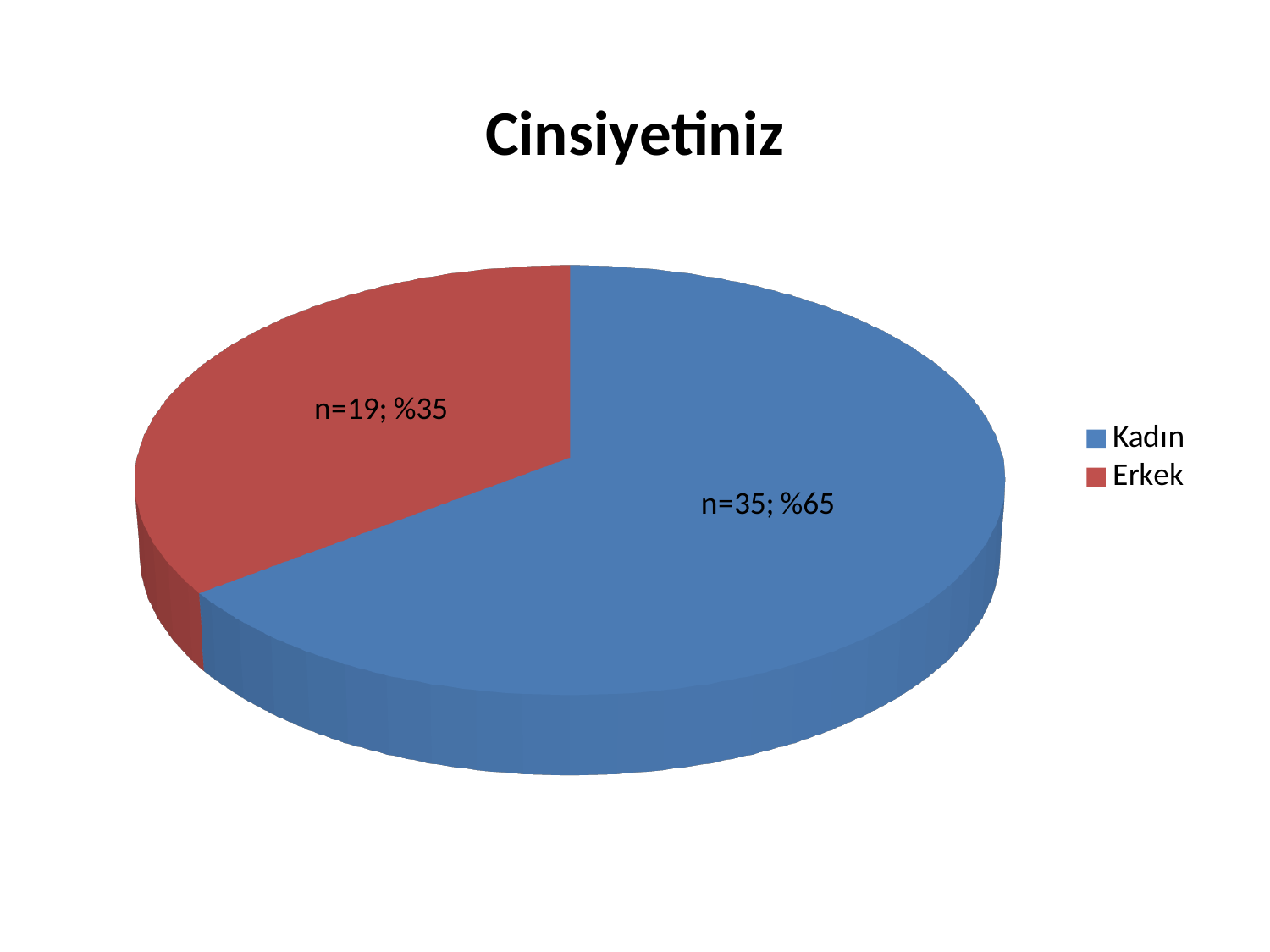
What is the count (n) for Kadın? n=35 What share of the pie does Kadın represent? %65 What is the title of the chart? Cinsiyetiniz What is the count (n) for Erkek? n=19 How many slices does the pie chart have? 2 Which colour represents Erkek in the chart? red What share of the pie does Erkek represent? %35 What kind of chart is shown on the slide? pie chart What is the difference in count between Kadın and Erkek? 16 Which category has the smallest slice? Erkek Which category has the largest slice? Kadın How many categories does the legend list? 2